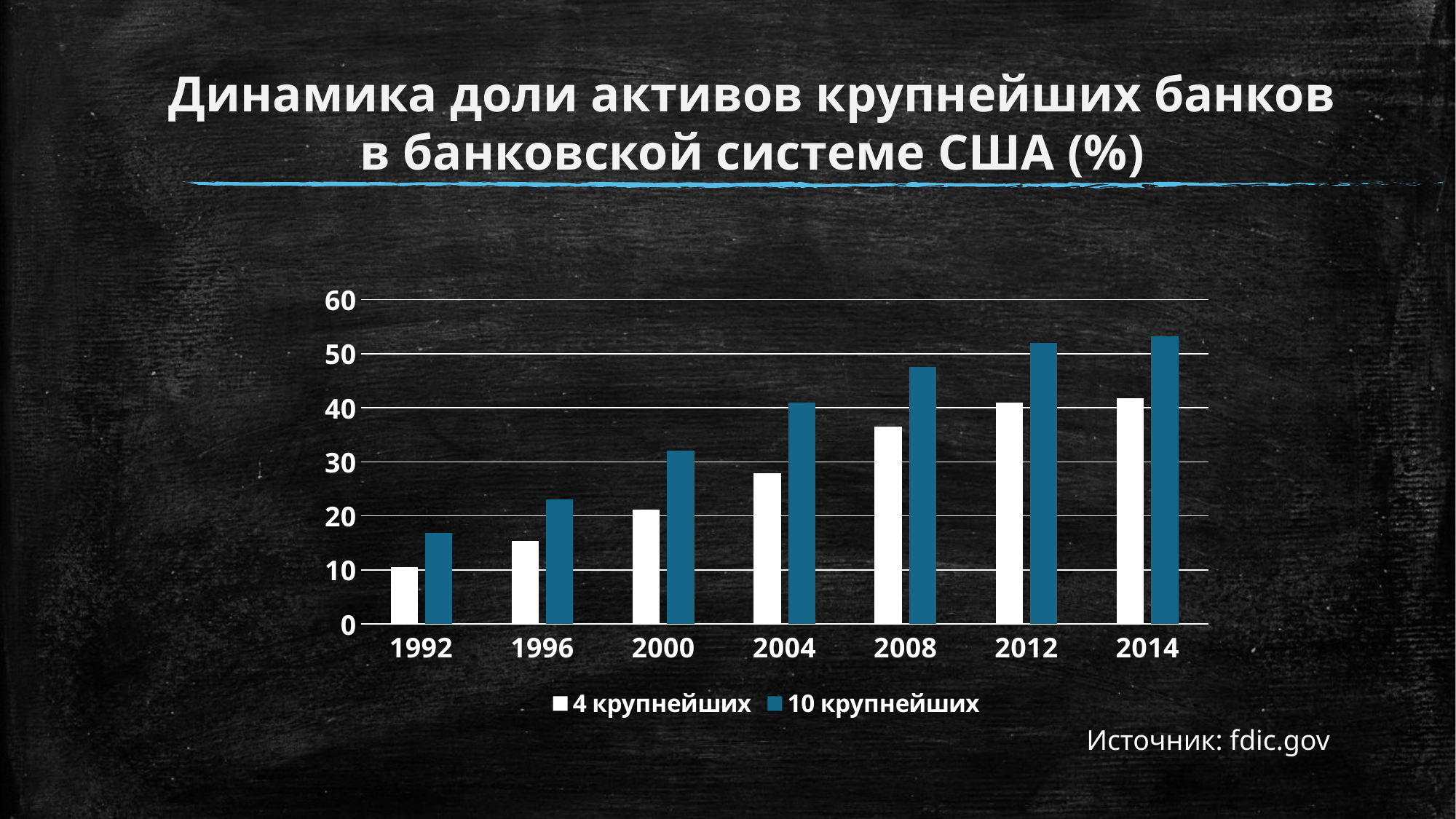
How many series does the legend list? 2 Is the value for 10 крупнейших in 2000 greater or less than 30? greater Which colour represents the series 10 крупнейших in the legend? blue Is the value for 10 крупнейших in 2012 greater or less than 50? greater Which year has the lowest value for 10 крупнейших? 1992 Which is larger: 10 крупнейших in 2008 or 4 крупнейших in 2012? 10 крупнейших in 2008 Is the value for 4 крупнейших in 2008 greater or less than 40? less How many years are shown on the x axis? 7 Which year has the lowest value for 4 крупнейших? 1992 What kind of chart is shown on the slide? bar chart Do the values for 10 крупнейших rise or fall from 1992 to 2014? rise